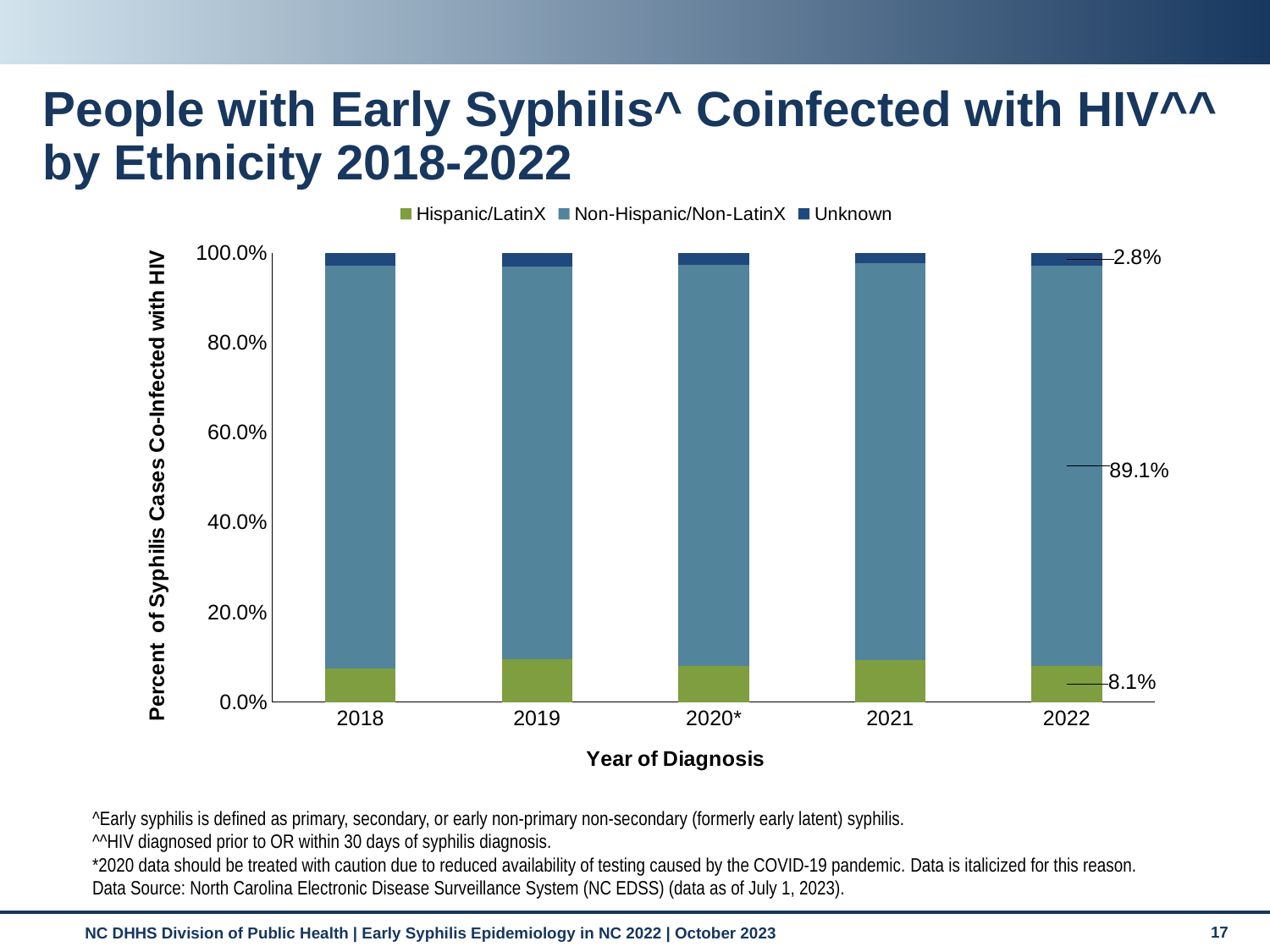
How many years are shown on the x axis? 5 What is the label of the x axis? Year of Diagnosis Which series makes up the largest portion of every bar? Non-Hispanic/Non-LatinX How many series does the legend list? 3 What kind of chart is shown on the slide? stacked bar chart What is the difference between the Non-Hispanic/Non-LatinX and Hispanic/LatinX percentages in 2022? 81.0% What is the Unknown percentage for 2022? 2.8% What is the Non-Hispanic/Non-LatinX percentage for 2022? 89.1% What is the total of the stacked bar for 2022? 100.0% In 2022, which is larger: the Hispanic/LatinX share or the Unknown share? Hispanic/LatinX Is the Hispanic/LatinX value for 2019 greater or less than 20.0%? less What is the Hispanic/LatinX percentage for 2022? 8.1%